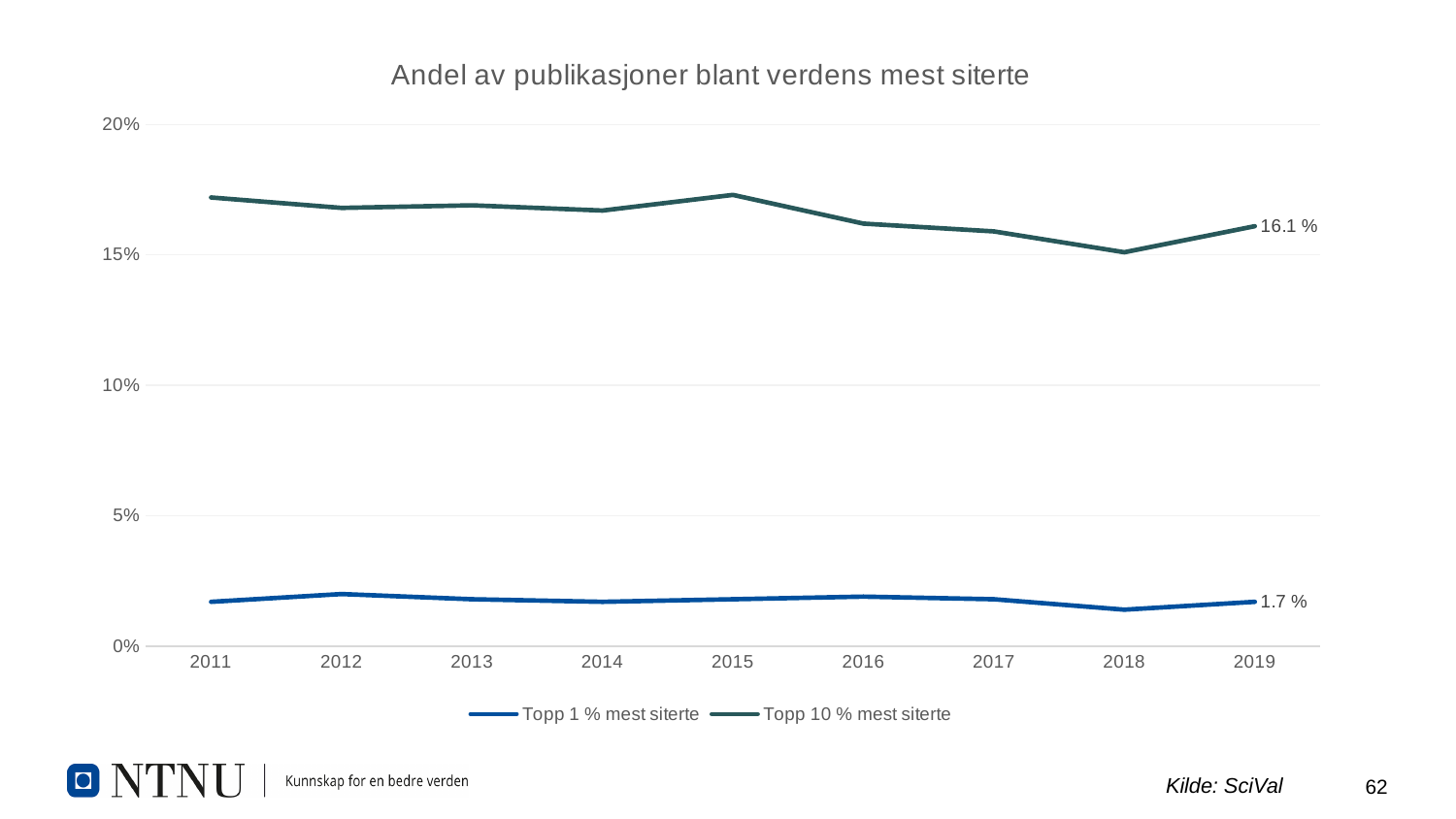
How many series does the legend list? 2 What is the value of the Topp 1 % mest siterte series in 2019? 1.7 % In which year is the Topp 1 % mest siterte series at its lowest? 2018 Is the value for Topp 1 % mest siterte in 2012 greater or less than 5%? less What is the title of the chart? Andel av publikasjoner blant verdens mest siterte In which year is the Topp 10 % mest siterte series at its lowest? 2018 What is the difference between the Topp 10 % mest siterte and Topp 1 % mest siterte values in 2019? 14.4 % In 2019, which series has the larger value, Topp 1 % mest siterte or Topp 10 % mest siterte? Topp 10 % mest siterte What is the value of the Topp 10 % mest siterte series in 2019? 16.1 % How many years are shown on the x axis? 9 Is the value for Topp 10 % mest siterte in 2015 greater or less than 15%? greater What kind of chart is shown on the slide? Line chart